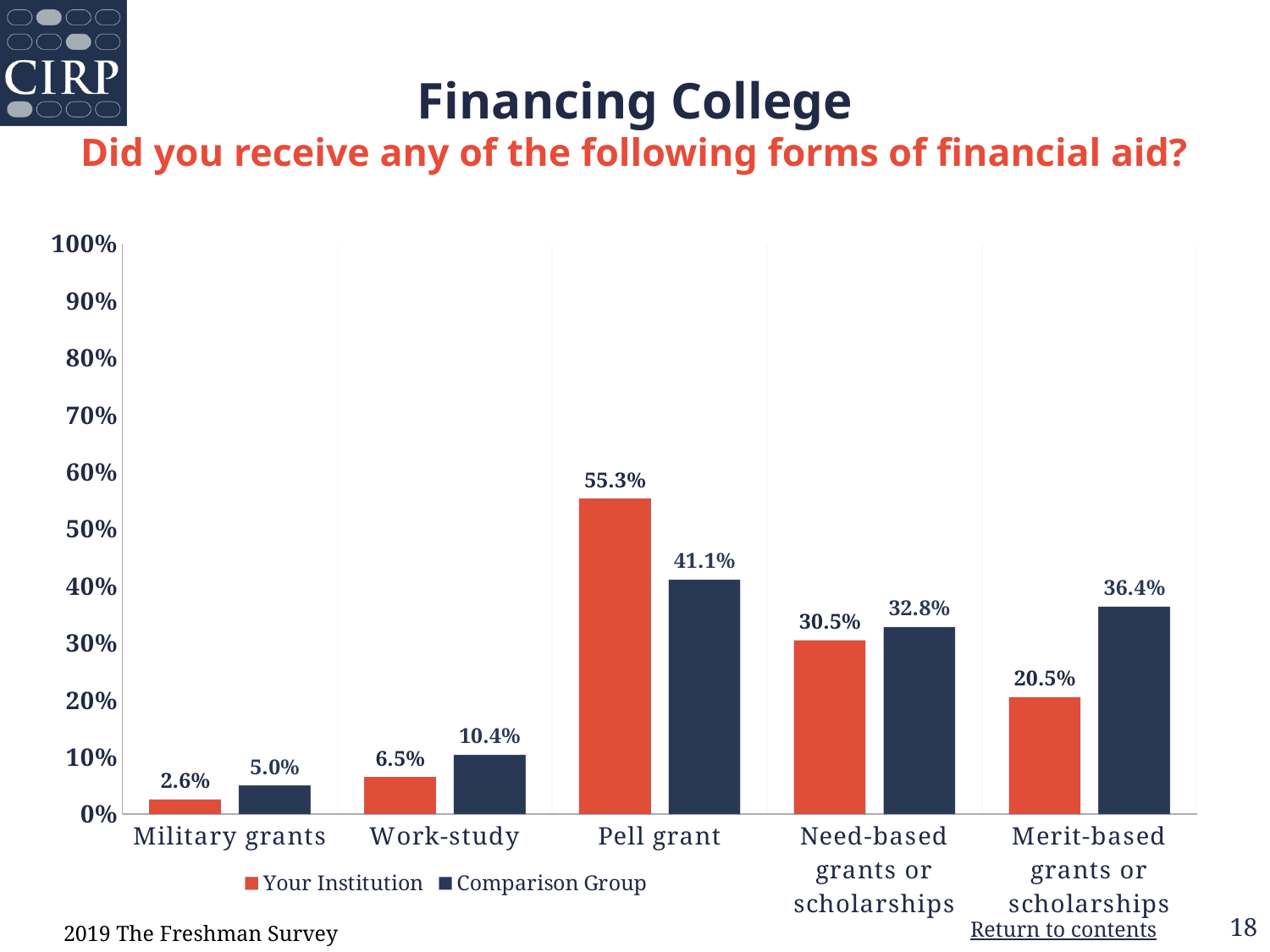
What is the Comparison Group value for Merit-based grants or scholarships? 36.4% How many series does the legend list? 2 What percentage of Your Institution students received a Pell grant? 55.3% What is the difference between Your Institution and the Comparison Group for Pell grant? 14.2% Which form of financial aid has the highest value for Your Institution? Pell grant Is the Comparison Group value for Pell grant greater or less than 50%? less For Need-based grants or scholarships, which is larger: Your Institution or the Comparison Group? Comparison Group What is the difference between the Comparison Group and Your Institution for Merit-based grants or scholarships? 15.9% What kind of chart is shown on the slide? Bar chart How many forms of financial aid are shown on the x axis? 5 What is the Your Institution value for Work-study? 6.5% Which form of financial aid has the lowest value for the Comparison Group? Military grants